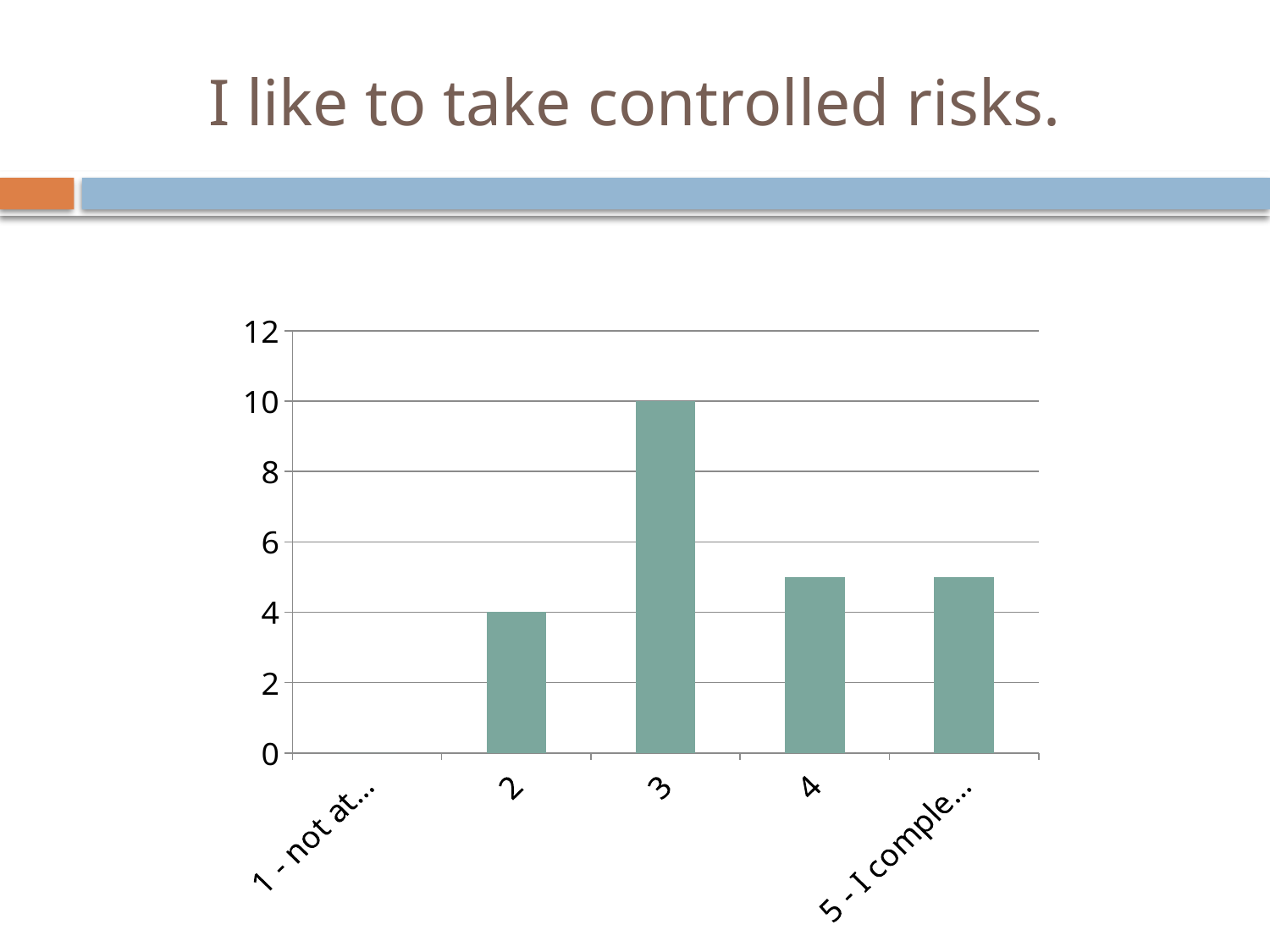
What kind of chart is shown on the slide? bar chart Which is larger, the value for category 2 or the value for category 3? 3 Is the value for category 3 greater or less than 8? greater Is the value for category 4 greater or less than 6? less What is the value for category 3? 10 What is the value for category 2? 4 What is the highest value shown on the vertical axis? 12 Is the value for category 4 greater or less than 4? greater What is the title of the slide above the chart? I like to take controlled risks. How many categories are shown on the x axis? 5 Which category has the highest value? 3 What is the difference between the values for category 3 and category 2? 6